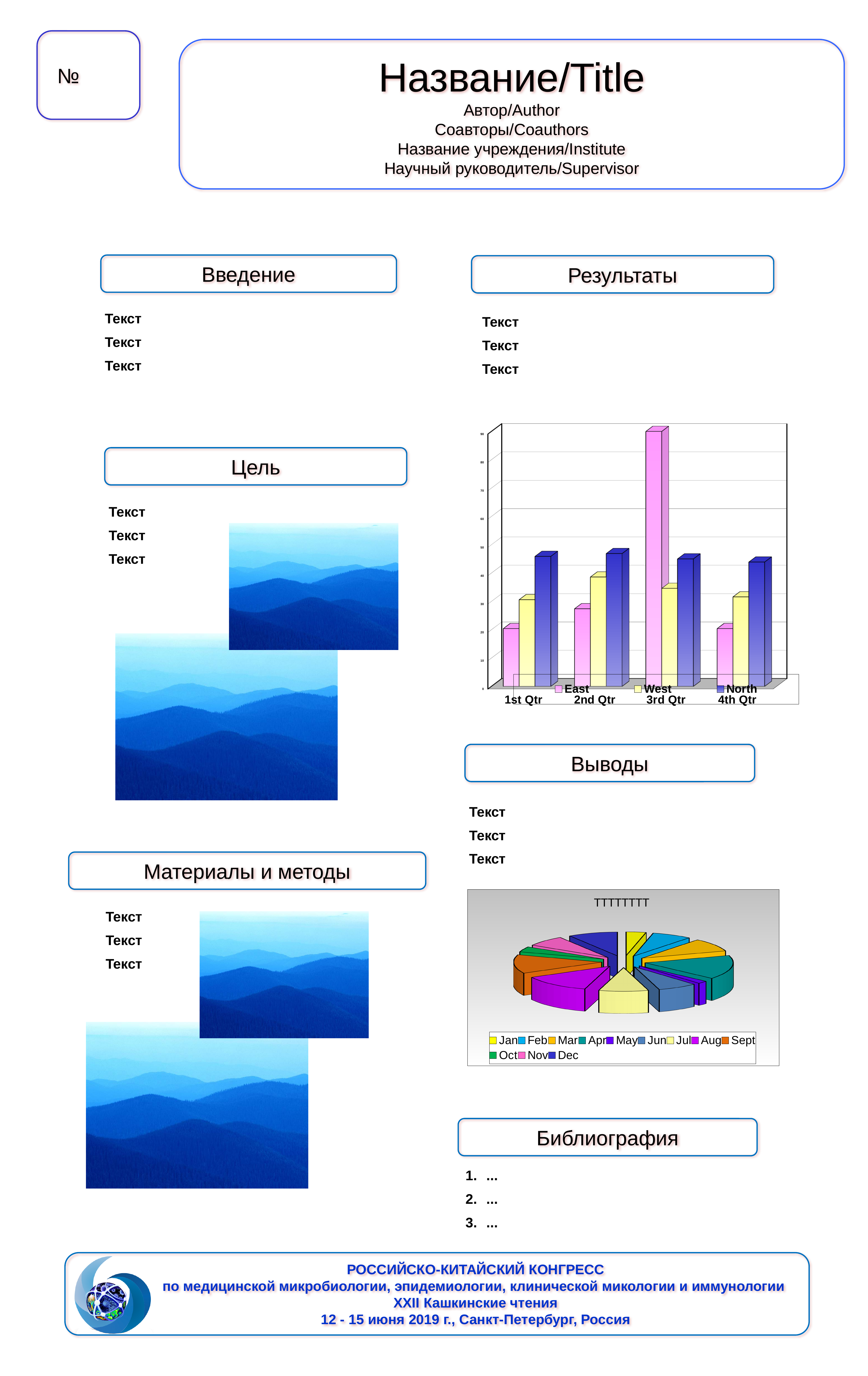
In the bar chart with quarters on the x axis, how many categories are shown on the x axis? 4 In the bar chart with quarters on the x axis, is the East value for 3rd Qtr greater or less than 80? greater In the bar chart with quarters on the x axis, what are the three series named in the legend? East, West, North What kind of chart is the upper chart on the right side of the slide (with 1st Qtr to 4th Qtr on the x axis)? bar chart In the bar chart with quarters on the x axis, how many series does the legend list? 3 What is the title of the pie chart on the slide? TTTTTTTT In the bar chart with quarters on the x axis, which is larger in 3rd Qtr, the East value or the West value? East What kind of chart is the lower chart on the right side of the slide (titled TTTTTTTT)? pie chart In the bar chart with quarters on the x axis, which is larger in 2nd Qtr, the East value or the North value? North In the pie chart titled TTTTTTTT, how many entries does the legend list? 12 In the bar chart with quarters on the x axis, is the East value for 1st Qtr greater or less than 30? less In the bar chart with quarters on the x axis, which quarter has the highest East value? 3rd Qtr